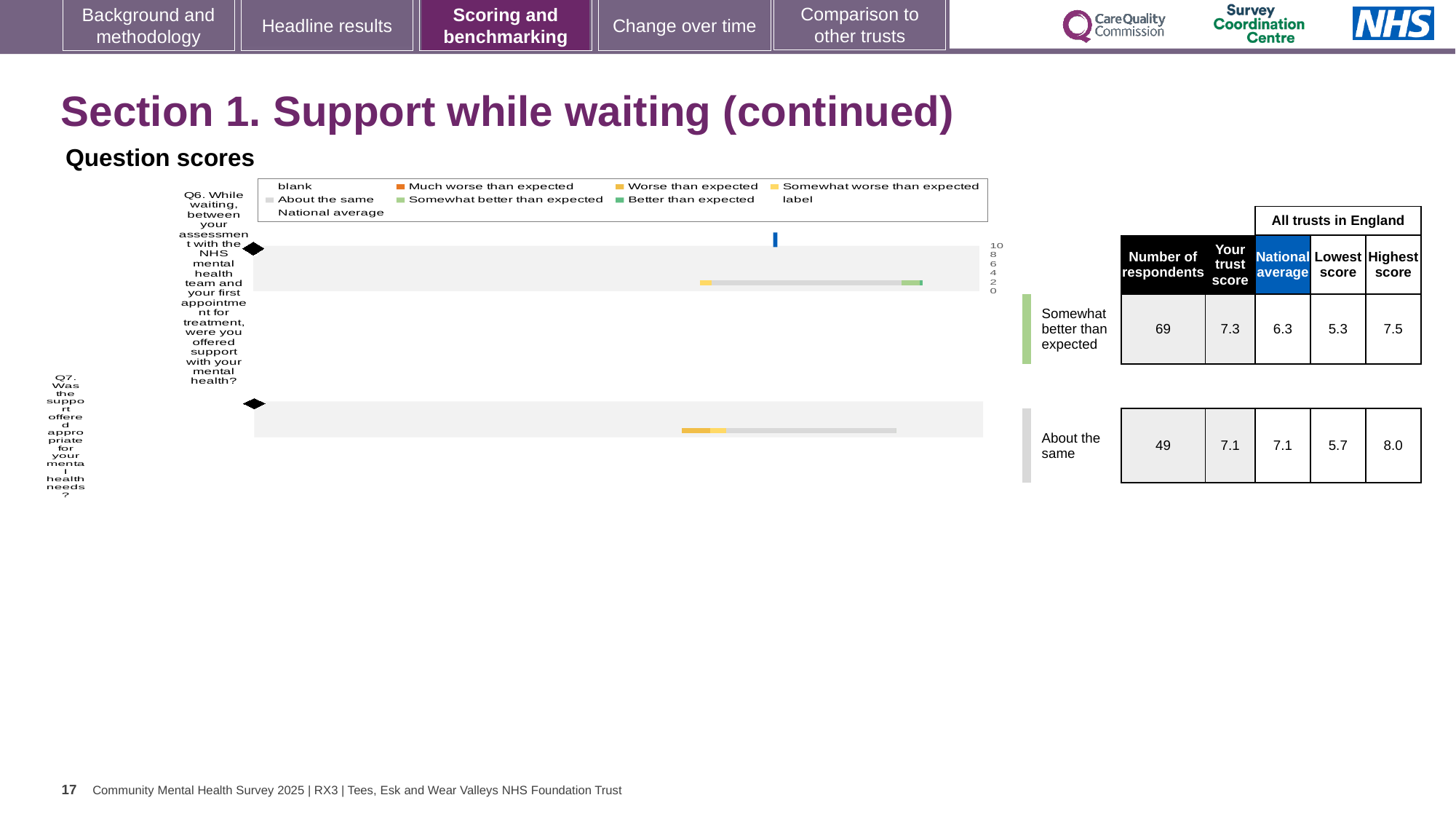
What kind of chart is shown under 'Question scores'? bar chart What is the lowest score among all trusts in England for Q6? 5.3 What is the 'Your trust score' for Q6 (support with your mental health while waiting)? 7.3 Which question has the larger number of respondents, Q6 or Q7? Q6 How many questions are plotted in the Question scores chart? 2 What benchmark category is shown for Q6 in the Question scores chart? Somewhat better than expected How many respondents answered Q7 (was the support offered appropriate for your mental health needs)? 49 What is the national average score for Q6? 6.3 What is the difference between the trust score and the national average for Q6? 1.0 For Q6, which is larger: the trust score or the national average? Your trust score What is the highest score among all trusts in England for Q7? 8.0 What is the difference between the highest and lowest scores for Q7? 2.3